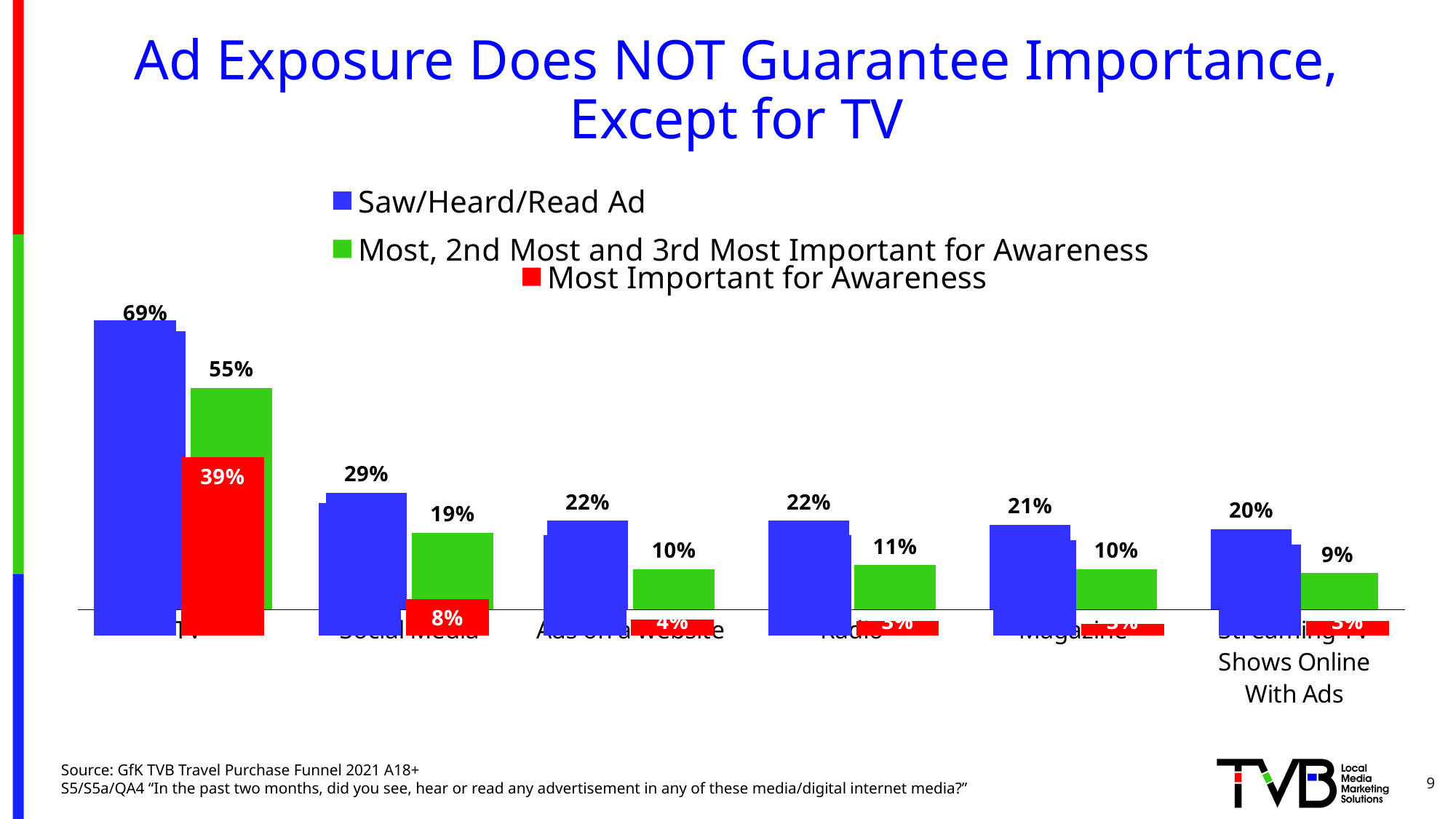
What is the Most, 2nd Most and 3rd Most Important for Awareness value for Social Media? 19% Which medium has the lowest Saw/Heard/Read Ad value? Streaming TV Shows Online With Ads What kind of chart is shown on the slide? Bar chart What is the difference between the Saw/Heard/Read Ad value and the Most Important for Awareness value for TV? 30 percentage points Which medium has the highest Saw/Heard/Read Ad value? TV What is the Saw/Heard/Read Ad value for Social Media? 29% Which has a higher Most, 2nd Most and 3rd Most Important for Awareness value, Radio or Magazine? Radio What is the Most Important for Awareness value for TV? 39% What is the Saw/Heard/Read Ad value for TV? 69% How many series does the legend list? 3 What is the difference between the Saw/Heard/Read Ad value and the Most, 2nd Most and 3rd Most Important for Awareness value for Social Media? 10 percentage points How many media categories are shown on the chart? 6